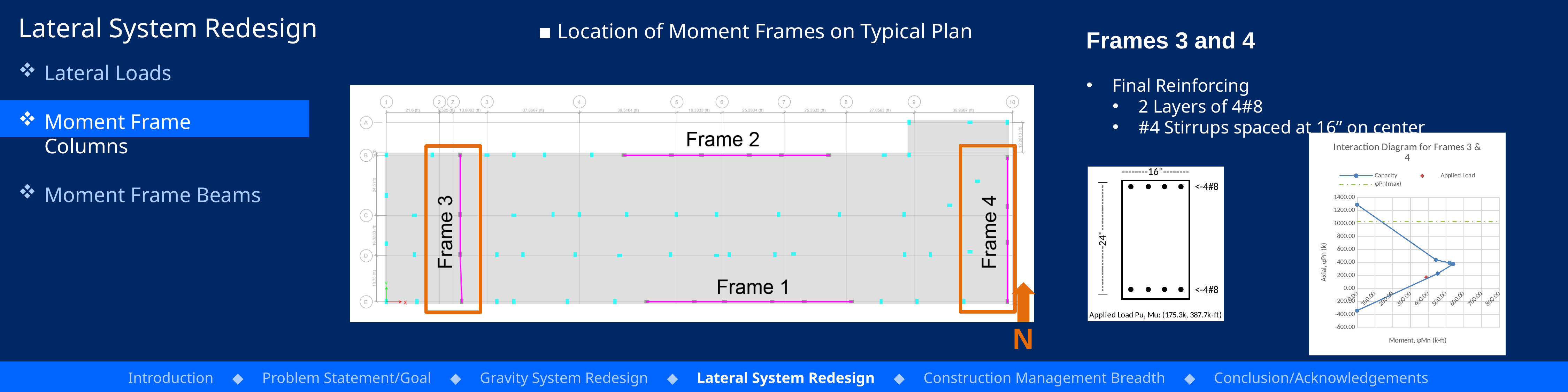
What is the title of the chart on the right side of the slide? Interaction Diagram for Frames 3 & 4 In the Interaction Diagram for Frames 3 & 4, is the φPn(max) line greater or less than 1200.00 on the axial axis? less In the Interaction Diagram for Frames 3 & 4, is the lowest Capacity point greater or less than -200.00 on the axial axis? less In the Interaction Diagram for Frames 3 & 4, is the Capacity value at zero moment greater or less than 1000.00 on the axial axis? greater What kind of chart is the Interaction Diagram for Frames 3 & 4? line chart In the Interaction Diagram for Frames 3 & 4, what is the label of the horizontal axis? Moment, φMn (k-ft) In the Interaction Diagram for Frames 3 & 4, which series reaches the highest axial value? Capacity In the Interaction Diagram for Frames 3 & 4, which is larger: the axial value of the Applied Load point or the φPn(max) line? φPn(max) How many series does the legend of the Interaction Diagram for Frames 3 & 4 list? 3